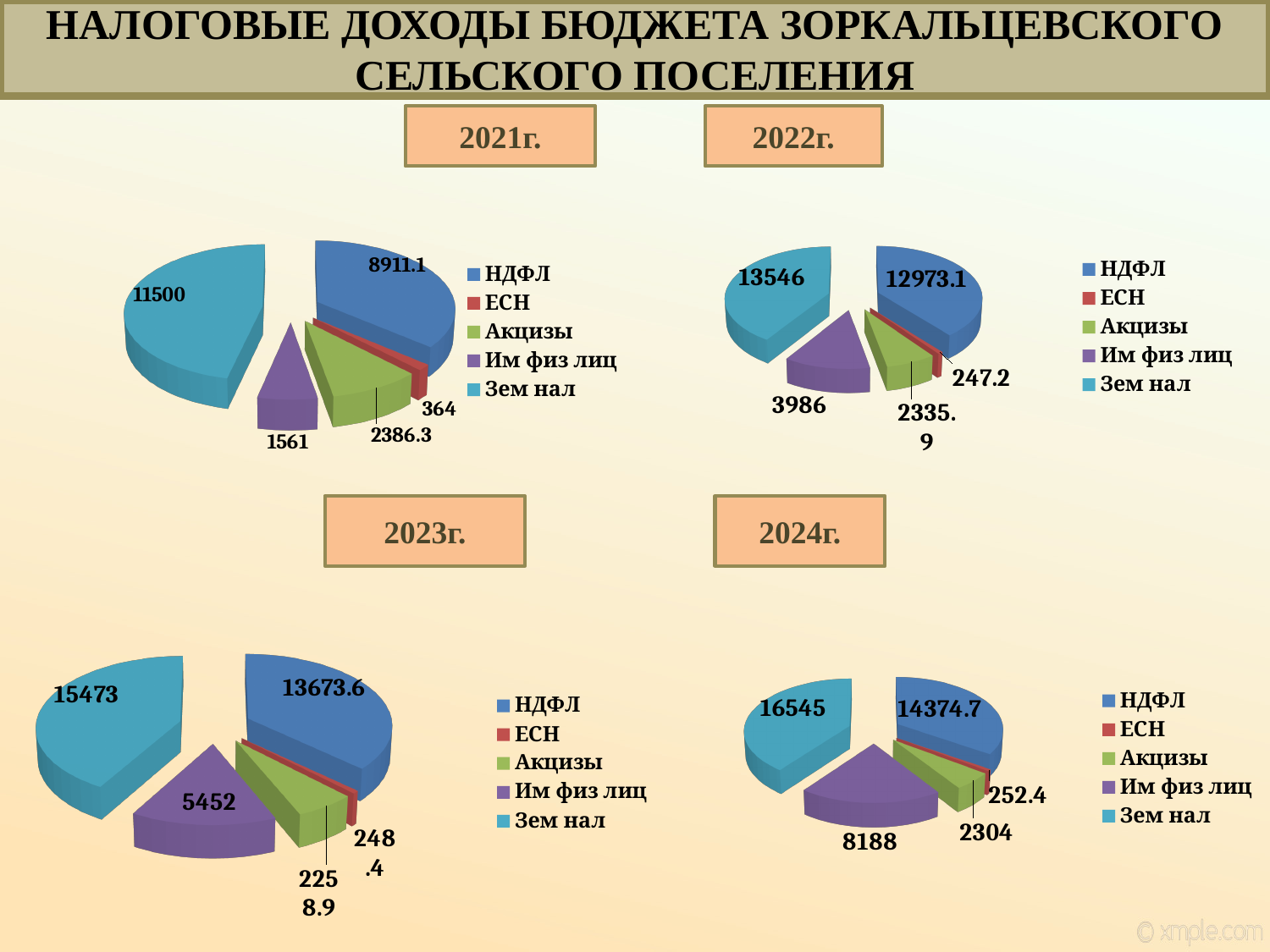
In the 2021г. pie chart, which category has the smallest value? ЕСН In the 2024г. pie chart, what is the difference between Зем нал and НДФЛ? 2170.3 In the 2023г. pie chart, what is the value for Им физ лиц? 5452 What type of chart is used for the 2021г. data? Pie chart In the 2022г. pie chart, what is the value for НДФЛ? 12973.1 In the 2024г. pie chart, what is the value for ЕСН? 252.4 In the 2021г. pie chart, what is the value for Зем нал? 11500 In the 2022г. pie chart, which is larger: Им физ лиц or Акцизы? Им физ лиц How many categories does the 2023г. pie chart show? 5 How many entries does the legend of the 2022г. chart list? 5 In the 2024г. pie chart, which category has the largest value? Зем нал How many pie charts are shown on the slide? 4